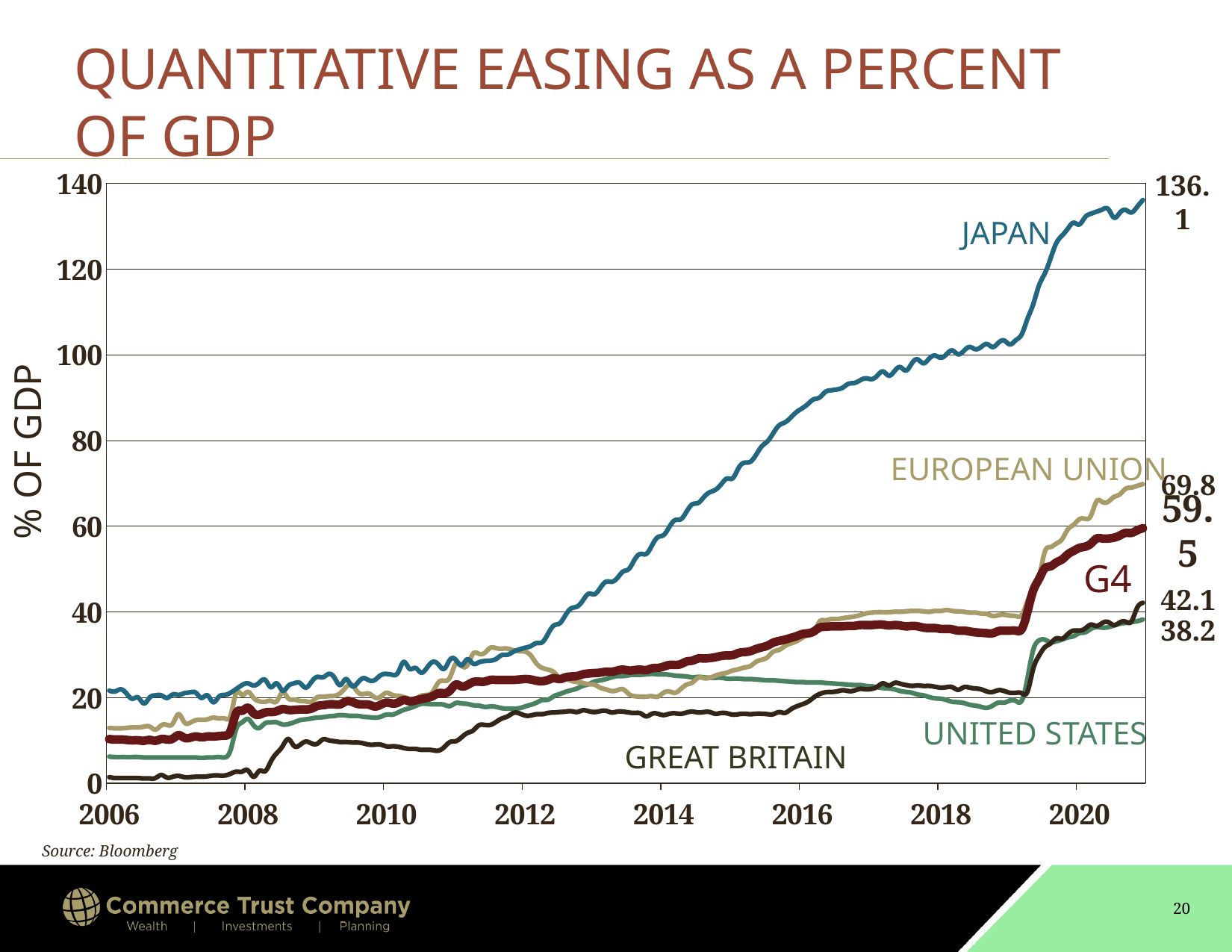
What is the final labelled value for G4? 59.5 What is the final labelled value for Japan? 136.1 Is the value for Great Britain in 2006 greater or less than 20? less Does the Japan series generally rise or fall from 2006 to 2020? rise How many series are labelled on the chart? 5 What is the difference between the final labelled values for Japan and the European Union? 66.3 What is the difference between the final labelled values for the European Union and G4? 10.3 What is the final labelled value for the European Union? 69.8 What kind of chart is shown on the slide? line chart Which series has the highest value at the end of the chart? Japan Is the value for Japan in 2014 greater or less than 40? greater At the end of the chart, which is larger: the European Union or G4? European Union